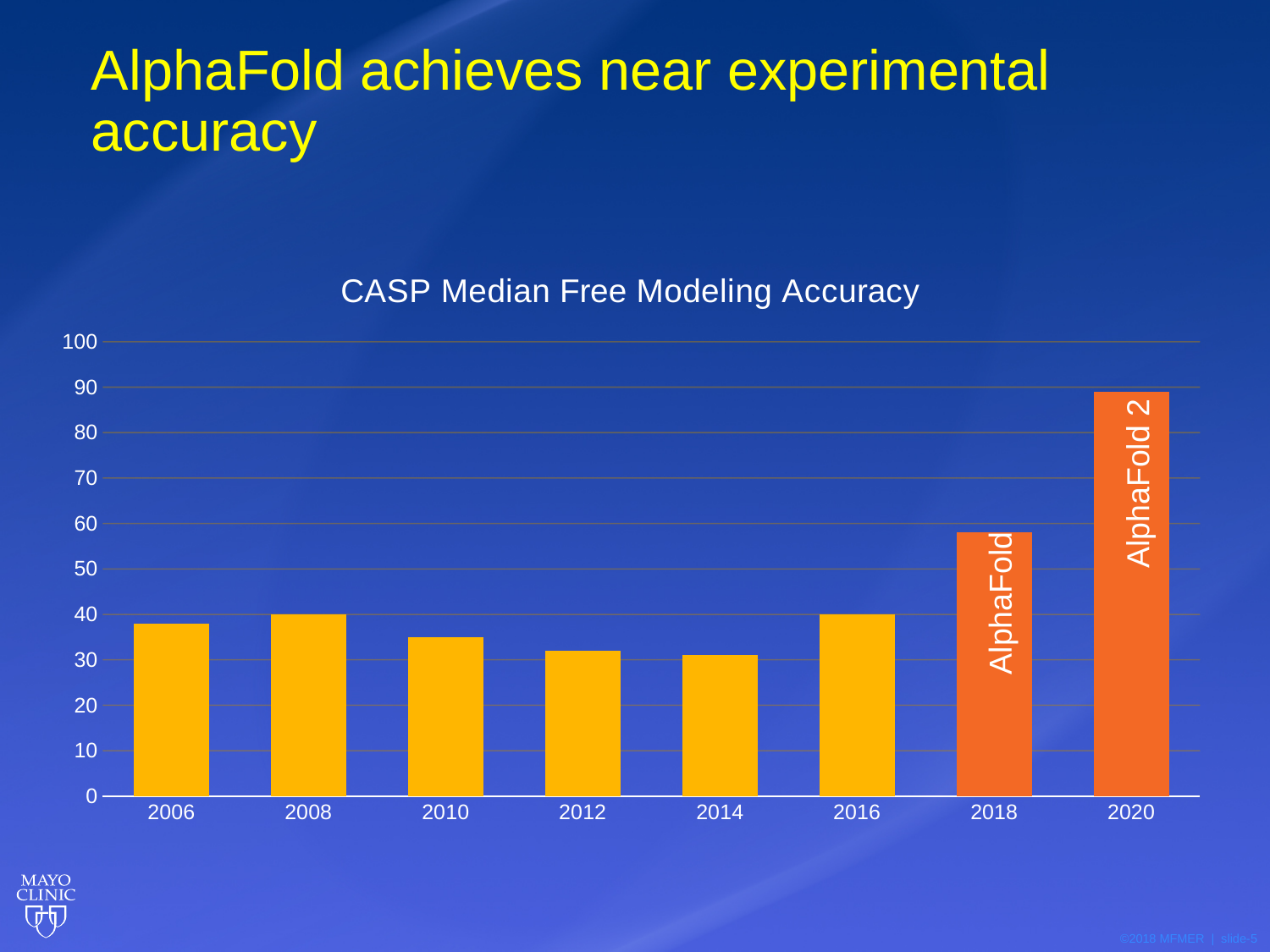
How many bars (years) are plotted in the chart? 8 Which is larger, the value for 2018 or the value for 2016? 2018 Which is larger, the value for 2020 or the value for 2018? 2020 Is the value for 2014 greater or less than 40? less Do the values rise or fall from 2016 to 2020? rise Is the value for 2018 greater or less than 50? greater Which bar is labeled 'AlphaFold 2'? 2020 Is the value for 2020 greater or less than 80? greater Which year has the highest CASP median free modeling accuracy? 2020 What type of chart is shown on the slide? bar chart What is the title of the chart? CASP Median Free Modeling Accuracy